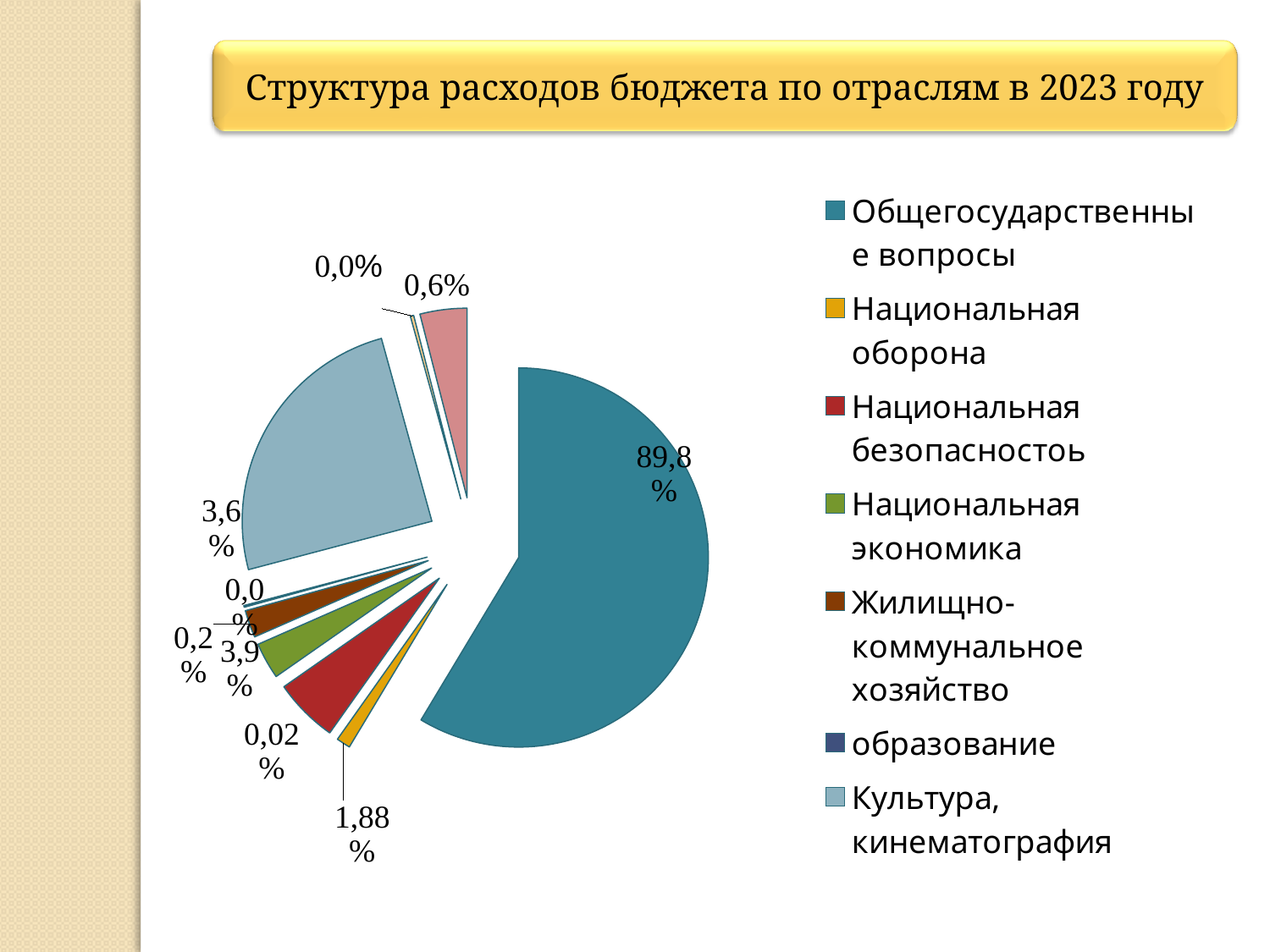
What kind of chart is shown on the slide? Pie chart What is the value shown for Национальная экономика? 3,9% What is the title of the chart? Структура расходов бюджета по отраслям в 2023 году How many entries does the legend list? 7 What is the value shown for Культура, кинематография? 3,6% Is the share for Общегосударственные вопросы greater or less than 50%? greater What is the difference between the shares of Национальная экономика and Культура, кинематография? 0,3% What share of the pie does Общегосударственные вопросы take? 89,8% What colour is the slice for Общегосударственные вопросы? Teal (blue-green) Which category has the largest slice of the pie? Общегосударственные вопросы What is the difference between the shares of Общегосударственные вопросы and Национальная экономика? 85,9%